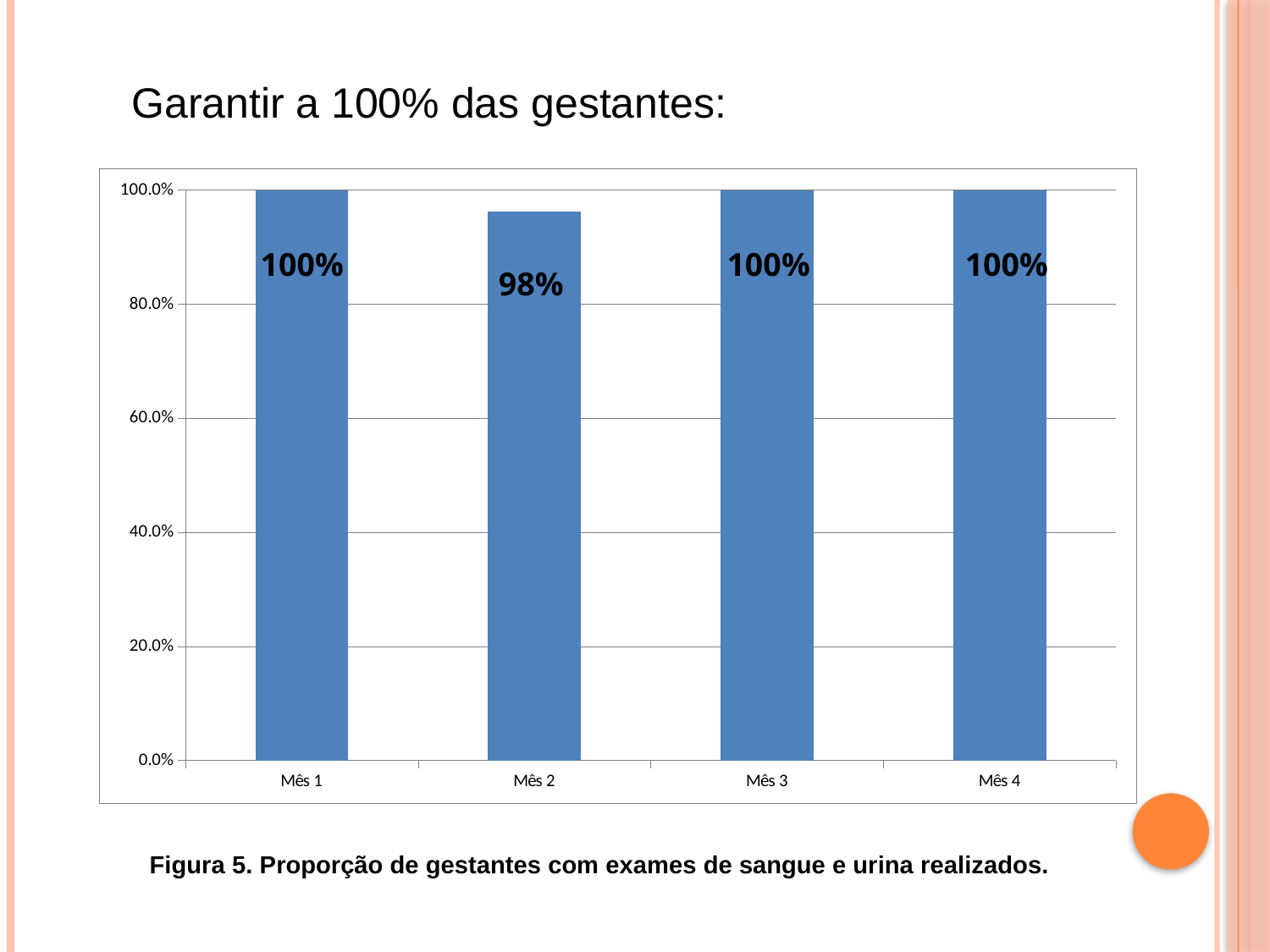
What colour are the bars in the chart? blue What is the value for Mês 1? 100% Which month has the lowest value? Mês 2 What is the value for Mês 2? 98% How many months have a value of 100%? 3 What kind of chart is shown on the slide? bar chart What is the caption of the figure below the chart? Figura 5. Proporção de gestantes com exames de sangue e urina realizados. How many months are shown on the x axis? 4 Which is larger, the value for Mês 2 or the value for Mês 3? Mês 3 What is the value for Mês 4? 100% What is the difference between the values for Mês 1 and Mês 2? 2% Is the value for Mês 2 greater or less than 80.0%? greater